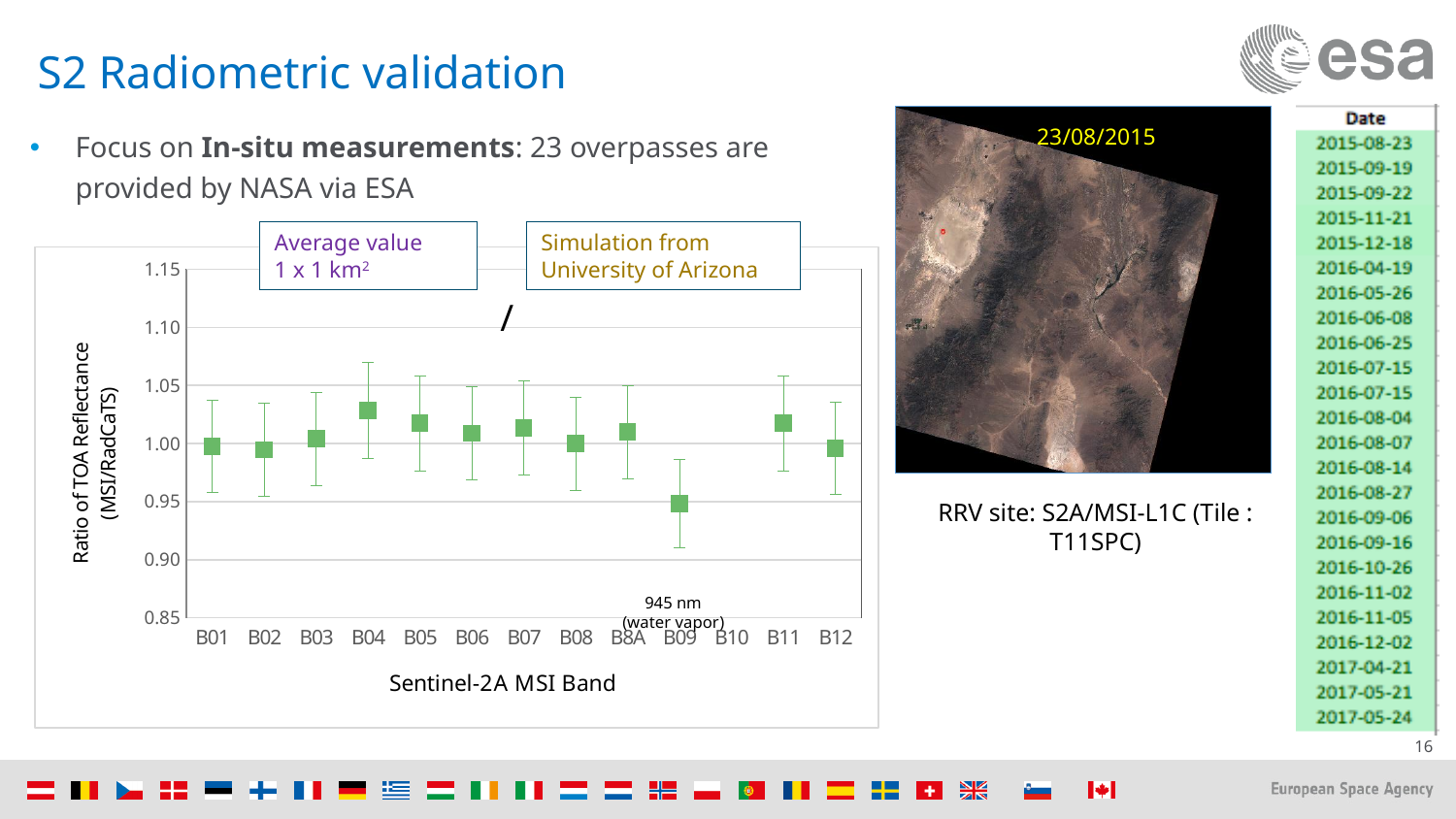
What wavelength annotation is shown next to the B09 point? 945 nm (water vapor) Is the value for B11 greater or less than 1.00? greater Is the value for B04 greater or less than 1.00? greater What kind of chart is shown on the slide? Scatter chart with error bars Is the value for B09 greater or less than 0.90? greater How many band labels are shown on the x axis of the chart? 13 Which has the larger ratio of TOA reflectance, B04 or B09? B04 Which band on the x axis has no data point plotted? B10 Which Sentinel-2A MSI band has the lowest ratio of TOA reflectance? B09 What is the title of the y axis of the chart? Ratio of TOA Reflectance (MSI/RadCaTS) Which has the larger ratio of TOA reflectance, B05 or B09? B05